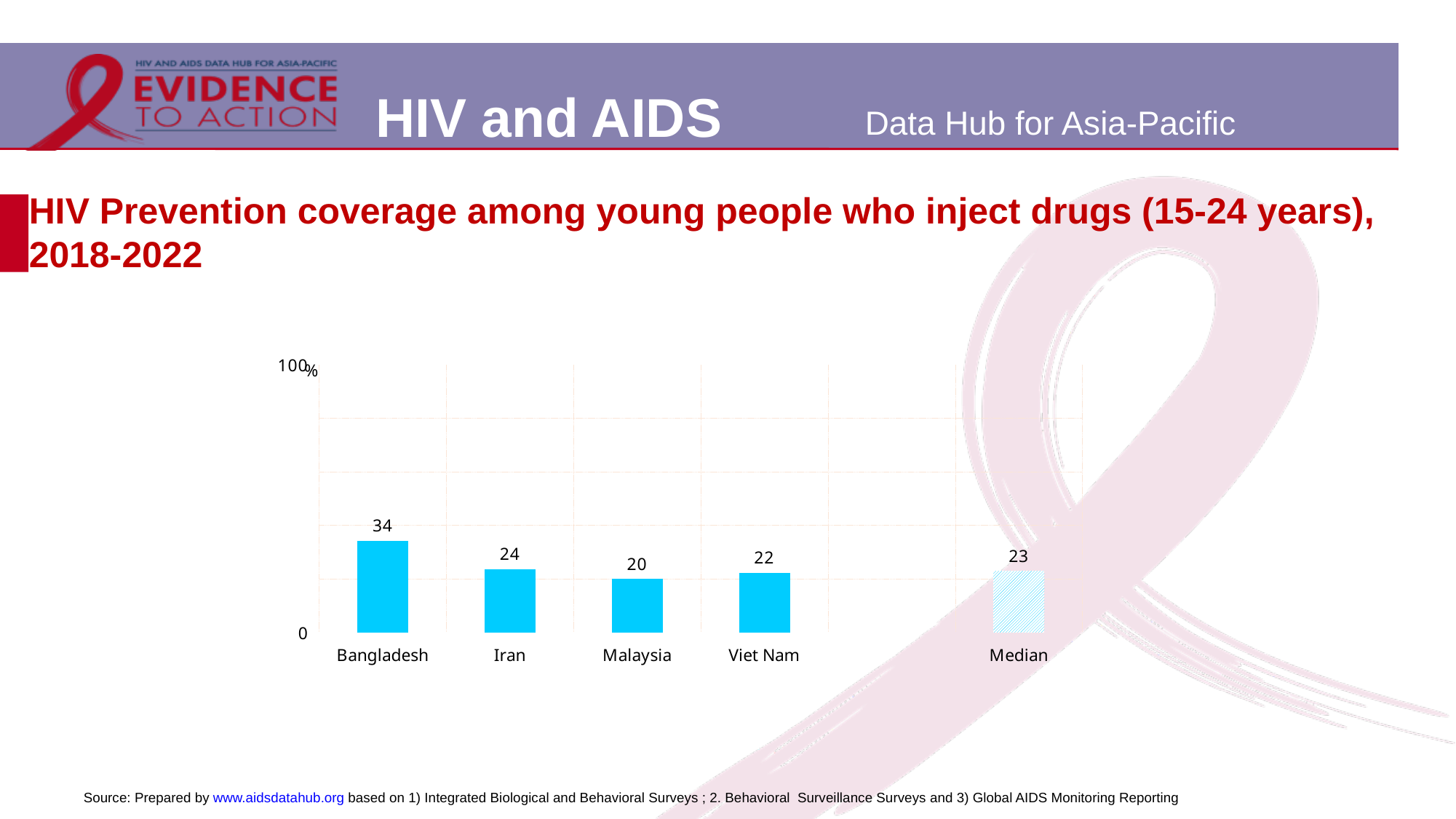
What is the difference between the values for Bangladesh and Malaysia? 14 Which country has the lowest HIV prevention coverage? Malaysia Which country has the highest HIV prevention coverage? Bangladesh What is the value for Viet Nam? 22 What is the value for Malaysia? 20 Which is larger, the value for Iran or the value for Viet Nam? Iran What is the value for Iran? 24 What kind of chart is shown on the slide? Bar chart What is the title of the chart on the slide? HIV Prevention coverage among young people who inject drugs (15-24 years), 2018-2022 What is the value shown for the Median bar? 23 How many countries are shown on the chart, excluding the Median bar? 4 What is the value for Bangladesh? 34